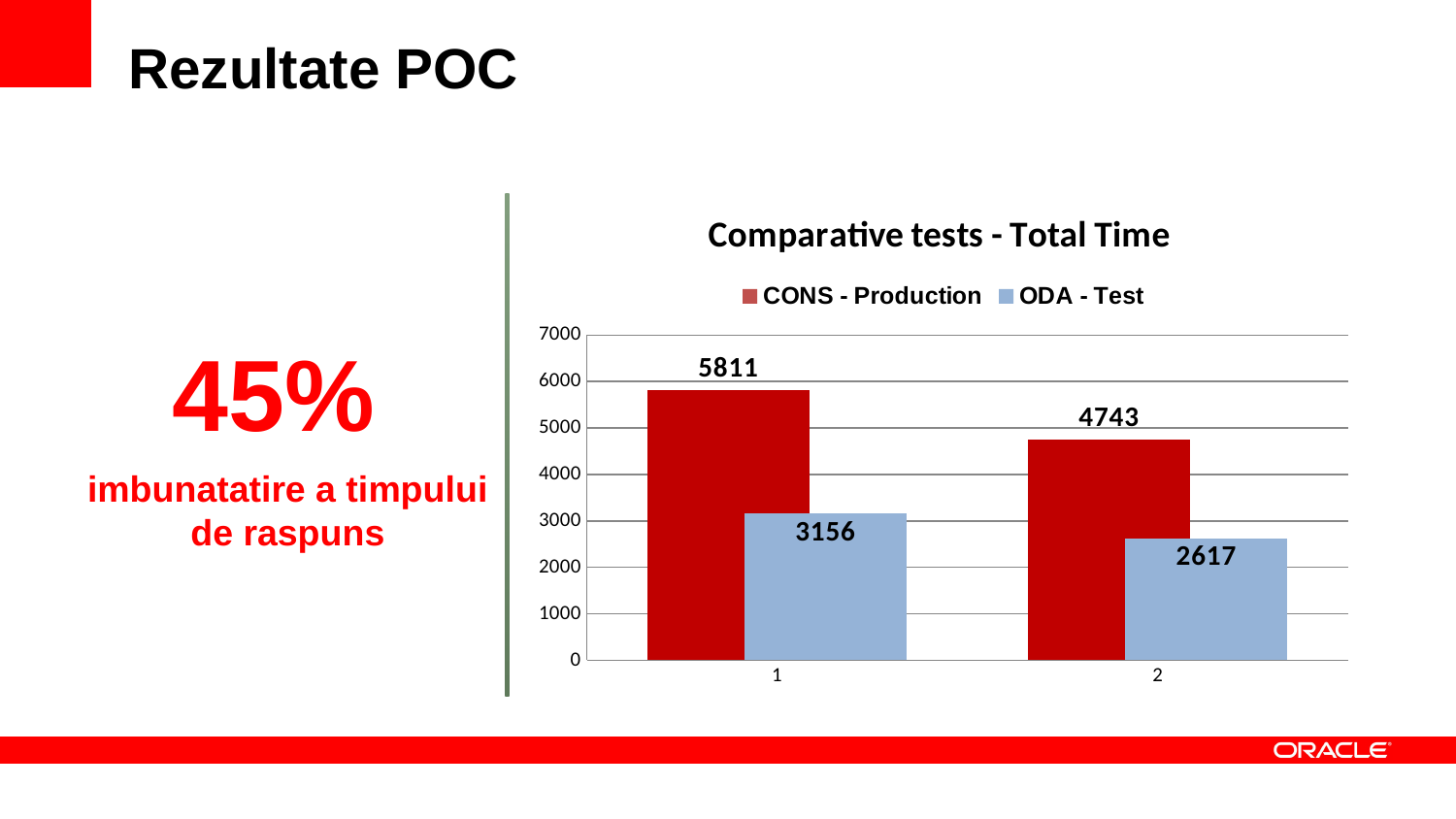
How many series does the legend list? 2 What is the difference between CONS - Production and ODA - Test in category 2? 2126 Which is larger: CONS - Production in category 2 or ODA - Test in category 1? CONS - Production in category 2 What is the value for CONS - Production in category 1? 5811 How many categories are shown on the x axis? 2 What is the difference between CONS - Production and ODA - Test in category 1? 2655 What is the value for ODA - Test in category 2? 2617 What is the value for ODA - Test in category 1? 3156 What is the title of the chart? Comparative tests - Total Time Which series has the highest value in category 2? CONS - Production Which bar has the lowest value on the chart? ODA - Test in category 2 What kind of chart is shown? Bar chart